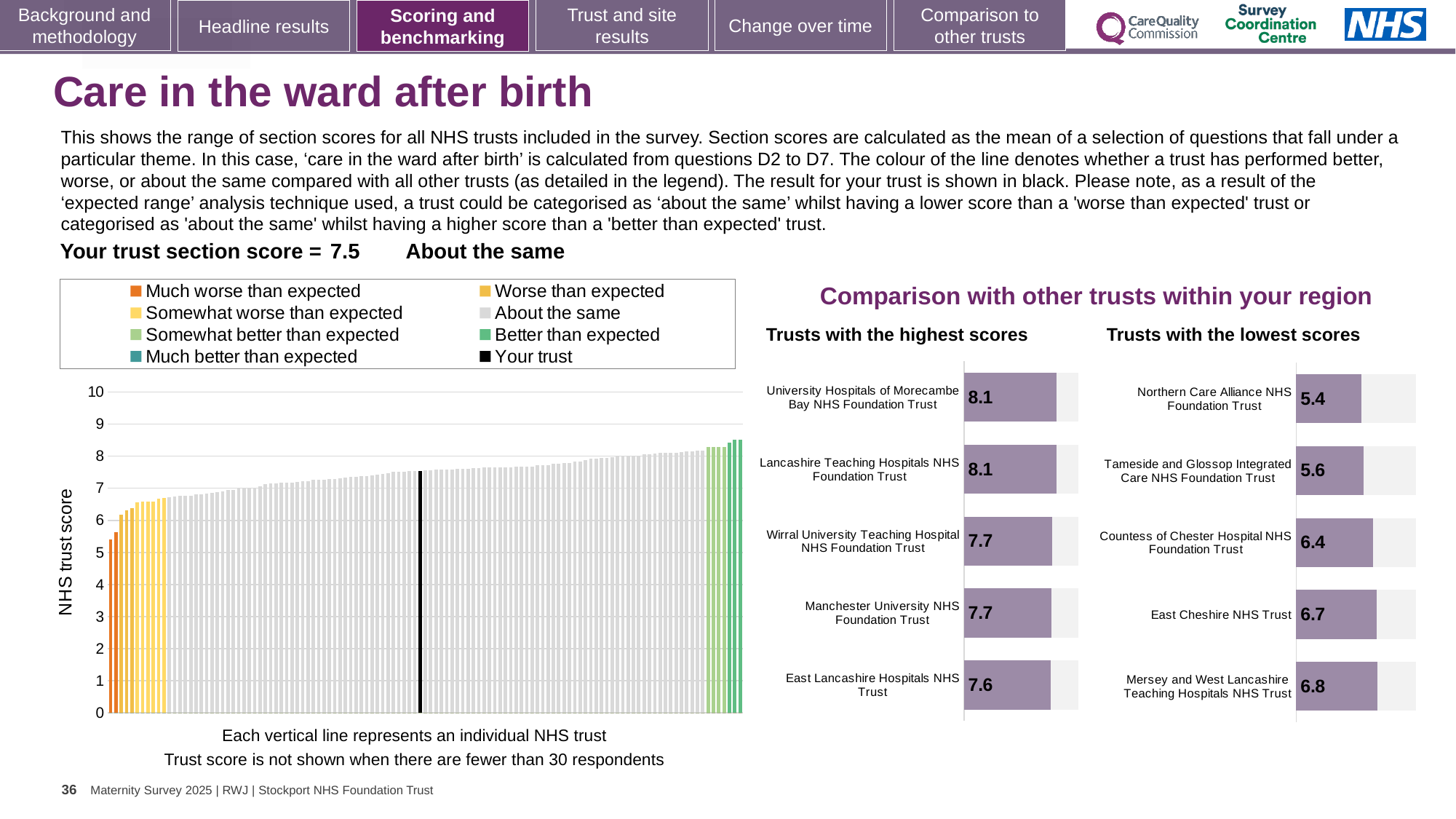
What type of chart is the main chart on the left of the slide? Bar chart In the 'Trusts with the highest scores' chart, what is the score for Wirral University Teaching Hospital NHS Foundation Trust? 7.7 In the 'Trusts with the highest scores' chart, what is the difference between the score for University Hospitals of Morecambe Bay NHS Foundation Trust and East Lancashire Hospitals NHS Trust? 0.5 In the 'Trusts with the lowest scores' chart, what is the score for Tameside and Glossop Integrated Care NHS Foundation Trust? 5.6 How many trusts are listed in the 'Trusts with the highest scores' chart? 5 In the 'Trusts with the lowest scores' chart, which trust has the lowest score? Northern Care Alliance NHS Foundation Trust In the 'Trusts with the highest scores' chart, which trust has the lowest score shown? East Lancashire Hospitals NHS Trust In the main chart on the left, do the trust scores rise or fall from left to right along the x axis? Rise In the 'Trusts with the lowest scores' chart, what is the difference between the score for Mersey and West Lancashire Teaching Hospitals NHS Trust and Northern Care Alliance NHS Foundation Trust? 1.4 How many entries does the legend of the main chart on the left list? 8 What is the section score for your trust shown on the main chart on the left? 7.5 In the 'Trusts with the lowest scores' chart, which has the higher score: Countess of Chester Hospital NHS Foundation Trust or Tameside and Glossop Integrated Care NHS Foundation Trust? Countess of Chester Hospital NHS Foundation Trust